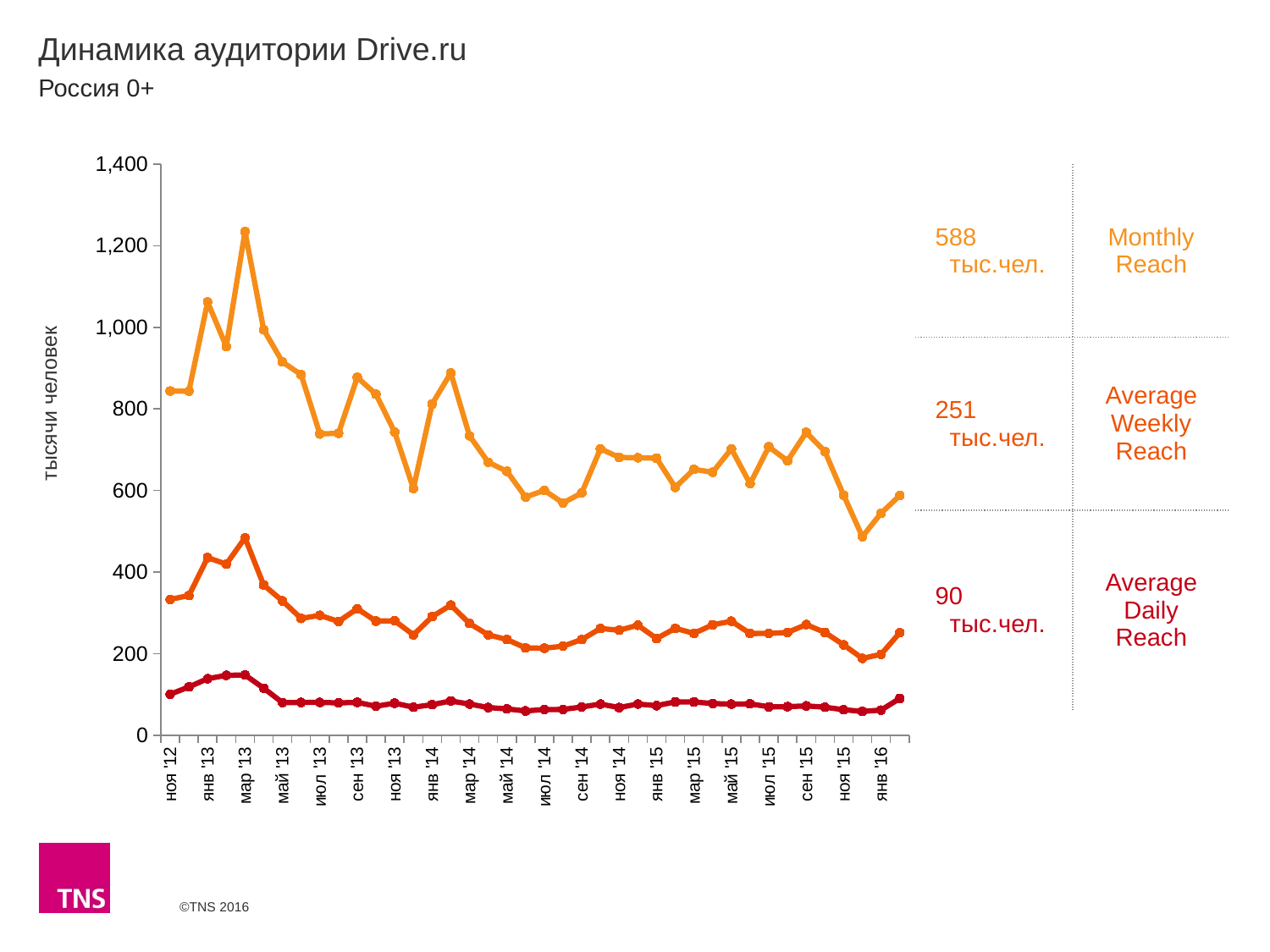
Which is larger, the Monthly Reach value for янв '13 or for янв '16? янв '13 What is the difference between the Monthly Reach and Average Weekly Reach values shown on the slide? 337 тыс.чел. Does the Monthly Reach line overall rise or fall from мар '13 to the end of the chart? fall What is the label on the vertical axis of the chart? тысячи человек Which series has the highest values throughout the chart? Monthly Reach What is the Monthly Reach value shown on the slide? 588 тыс.чел. What kind of chart is shown on the slide? line chart How many series are plotted on the chart? 3 Is the Average Daily Reach value for мар '13 greater or less than 200? less What is the Average Weekly Reach value shown on the slide? 251 тыс.чел. What is the Average Daily Reach value shown on the slide? 90 тыс.чел. Is the Monthly Reach value for мар '13 greater or less than 1,000? greater